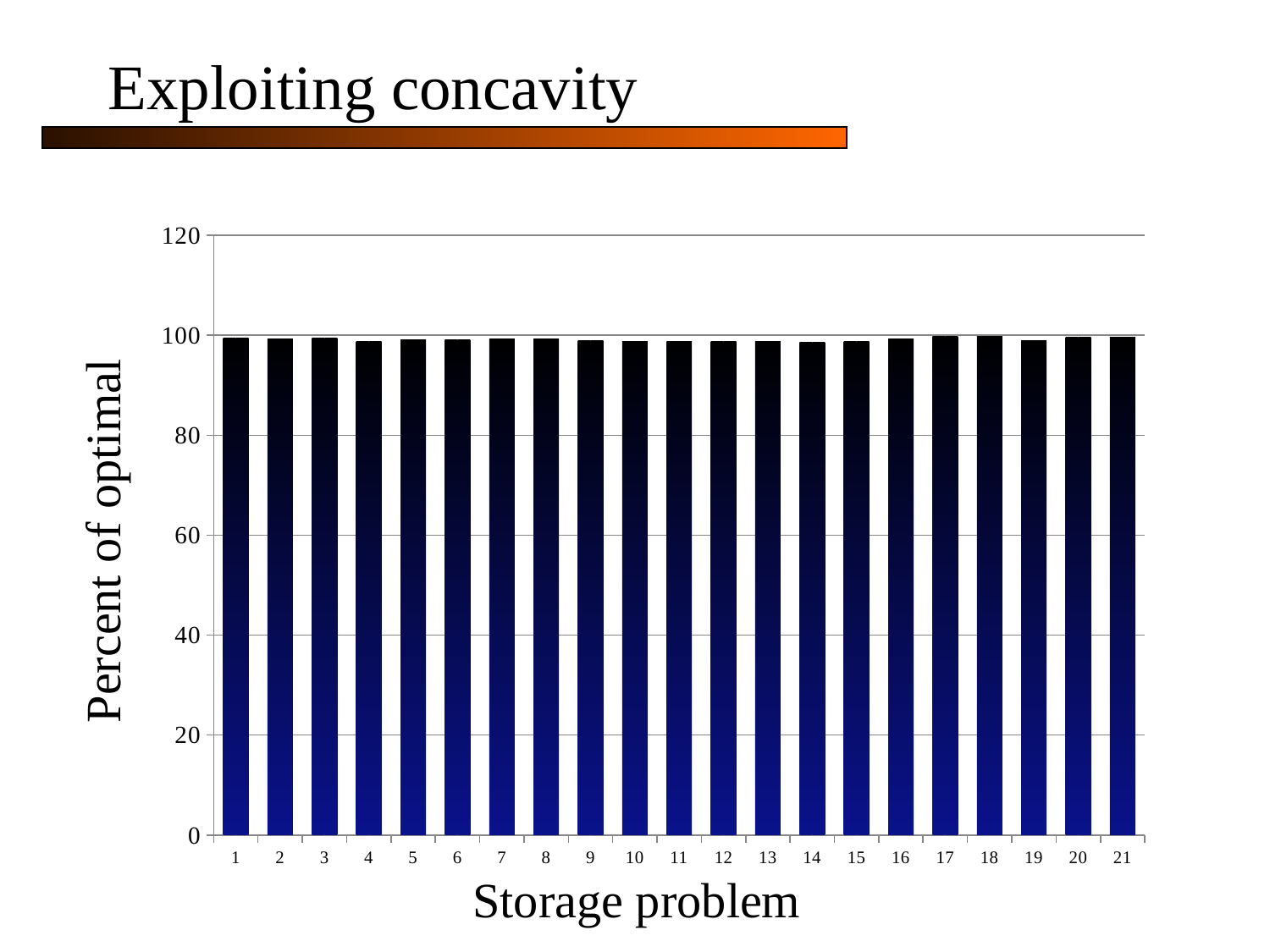
How many storage problems are plotted on the x axis? 21 What is the label of the x axis? Storage problem What is the highest tick value shown on the y axis? 120 Is the value for storage problem 14 greater or less than 120? less Is the value for storage problem 1 greater or less than 80? greater Is the value for storage problem 21 greater or less than 60? greater What kind of chart is shown on the slide? bar chart What is the label of the y axis? Percent of optimal